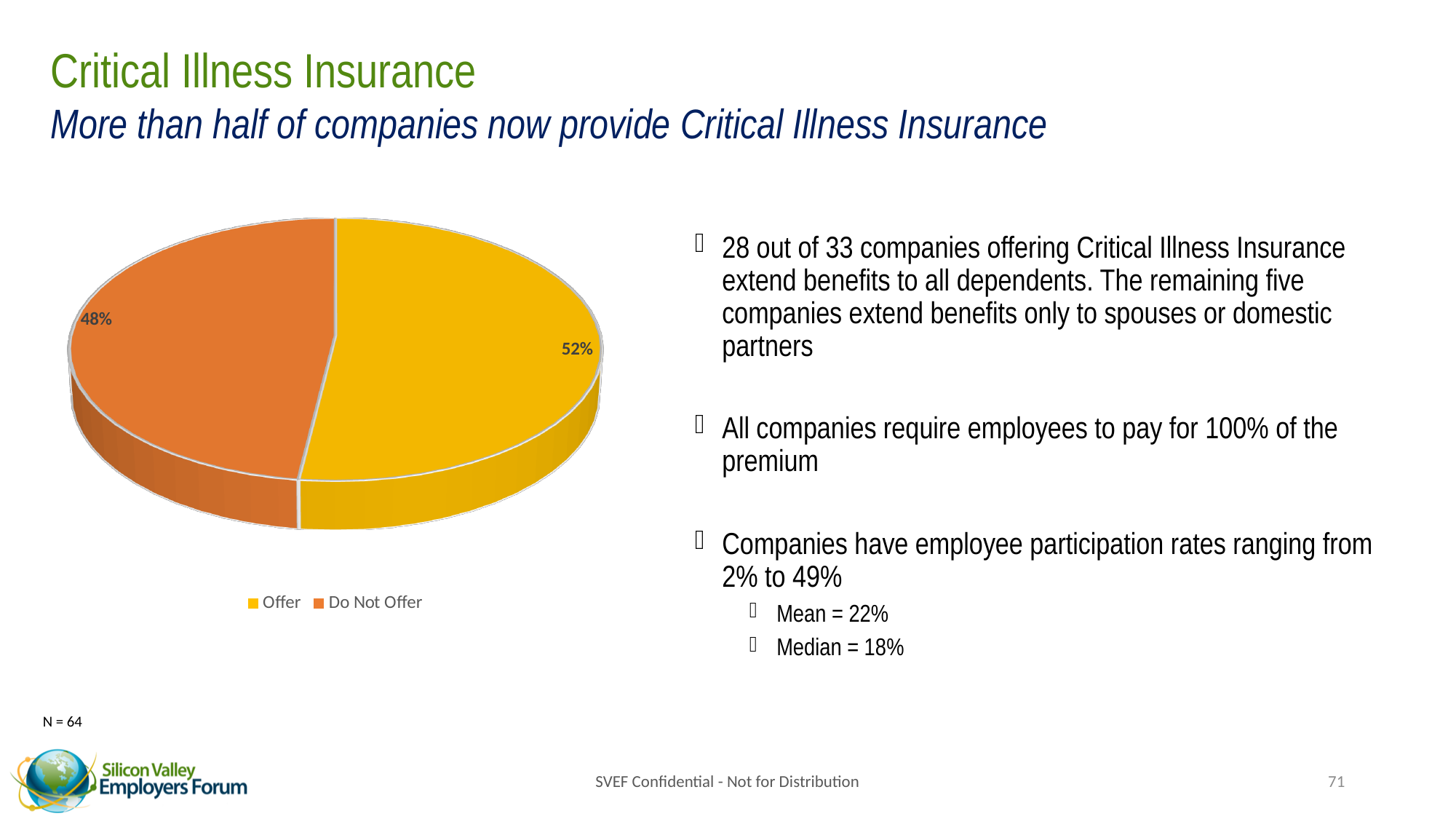
What type of chart is shown on the slide? Pie chart Which slice of the pie chart is smaller, Offer or Do Not Offer? Do Not Offer How many slices does the pie chart have? 2 Is the Do Not Offer slice greater or less than 50%? less What colour represents the Offer slice in the pie chart? Yellow What percentage of companies offer Critical Illness Insurance according to the pie chart? 52% What percentage of companies do not offer Critical Illness Insurance according to the pie chart? 48% Is the Offer slice greater or less than 50%? greater How many entries does the chart legend list? 2 What is the sample size (N) noted for the chart? 64 Which slice of the pie chart is larger, Offer or Do Not Offer? Offer What is the difference in percentage points between the Offer and Do Not Offer slices? 4